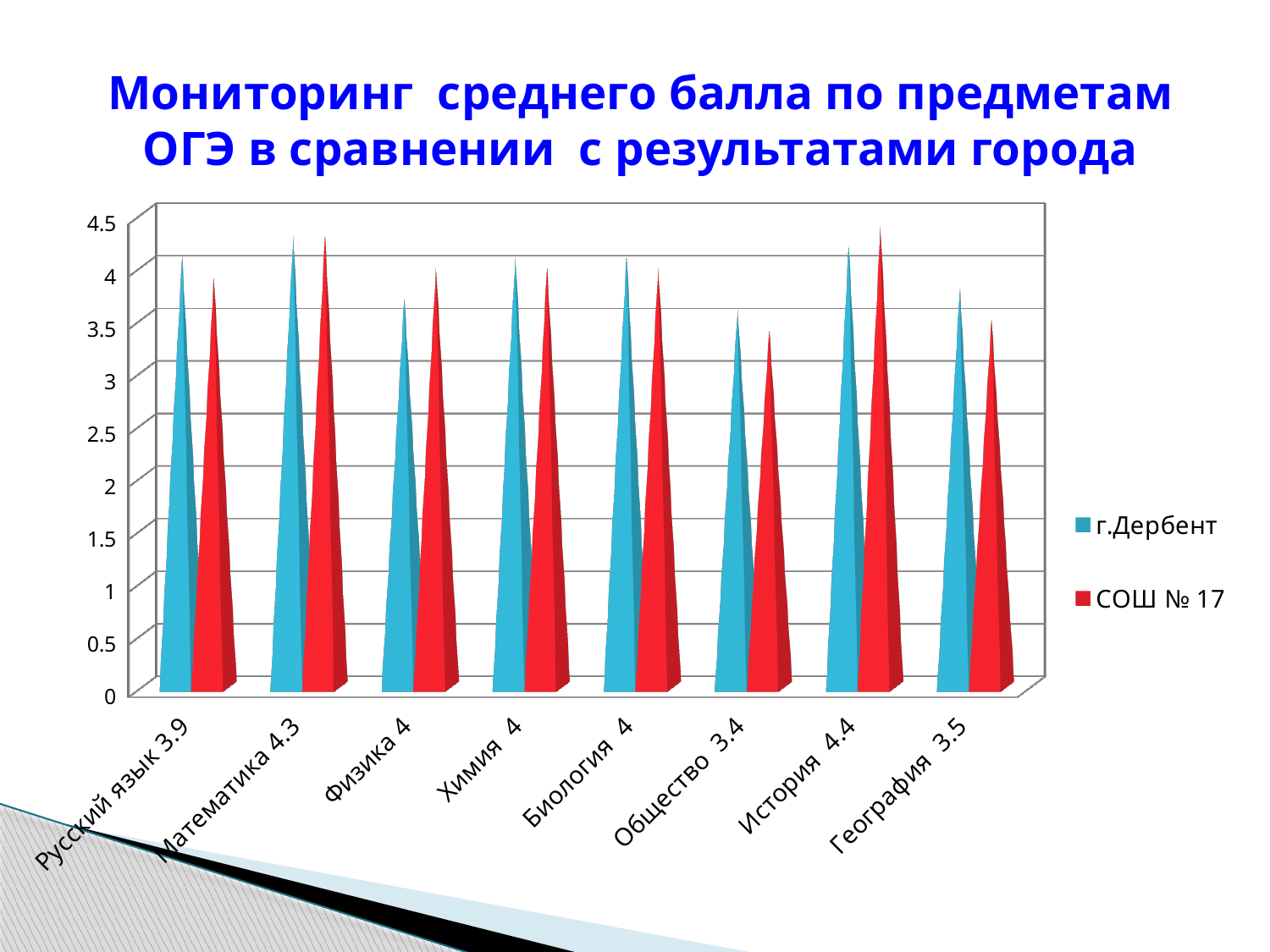
Is the г.Дербент value for Физика greater or less than 4? less How many subject categories are plotted on the x axis? 8 For Физика, which series has the larger value, г.Дербент or СОШ № 17? СОШ № 17 Is the г.Дербент value for Математика greater or less than 4? greater What colour represents the СОШ № 17 series? red How many series does the legend list? 2 Is the СОШ № 17 value for Общество greater or less than 4? less What are the two series named in the legend? г.Дербент and СОШ № 17 For География, which series has the larger value, г.Дербент or СОШ № 17? г.Дербент What kind of chart is shown on the slide? bar chart